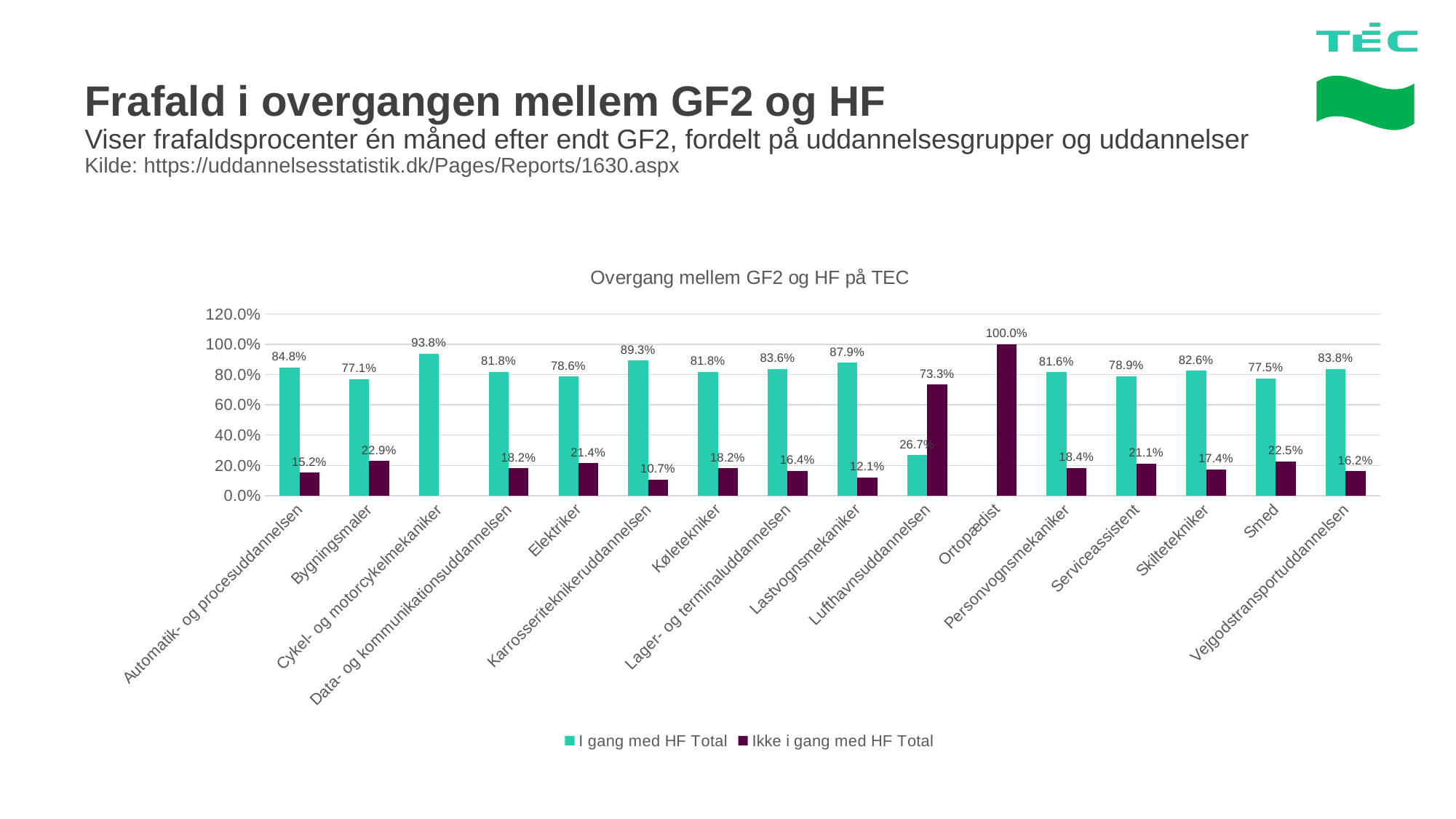
Which category has the highest value for "Ikke i gang med HF Total"? Ortopædist How many series does the legend list? 2 What is the value of "I gang med HF Total" for Smed? 77.5% Is the "I gang med HF Total" value for Lastvognsmekaniker greater or less than 80.0%? greater What is the value of "I gang med HF Total" for Cykel- og motorcykelmekaniker? 93.8% Which is larger: the "Ikke i gang med HF Total" value for Bygningsmaler or for Skiltetekniker? Bygningsmaler What kind of chart is shown on the slide? Bar chart Which category has the lowest value for "I gang med HF Total" among those with a teal bar? Lufthavnsuddannelsen What is the difference between the "I gang med HF Total" values for Karrosseriteknikeruddannelsen and Elektriker? 10.7% What is the value of "Ikke i gang med HF Total" for Lufthavnsuddannelsen? 73.3% What is the title of the chart? Overgang mellem GF2 og HF på TEC How many categories are shown on the x axis of the chart? 16